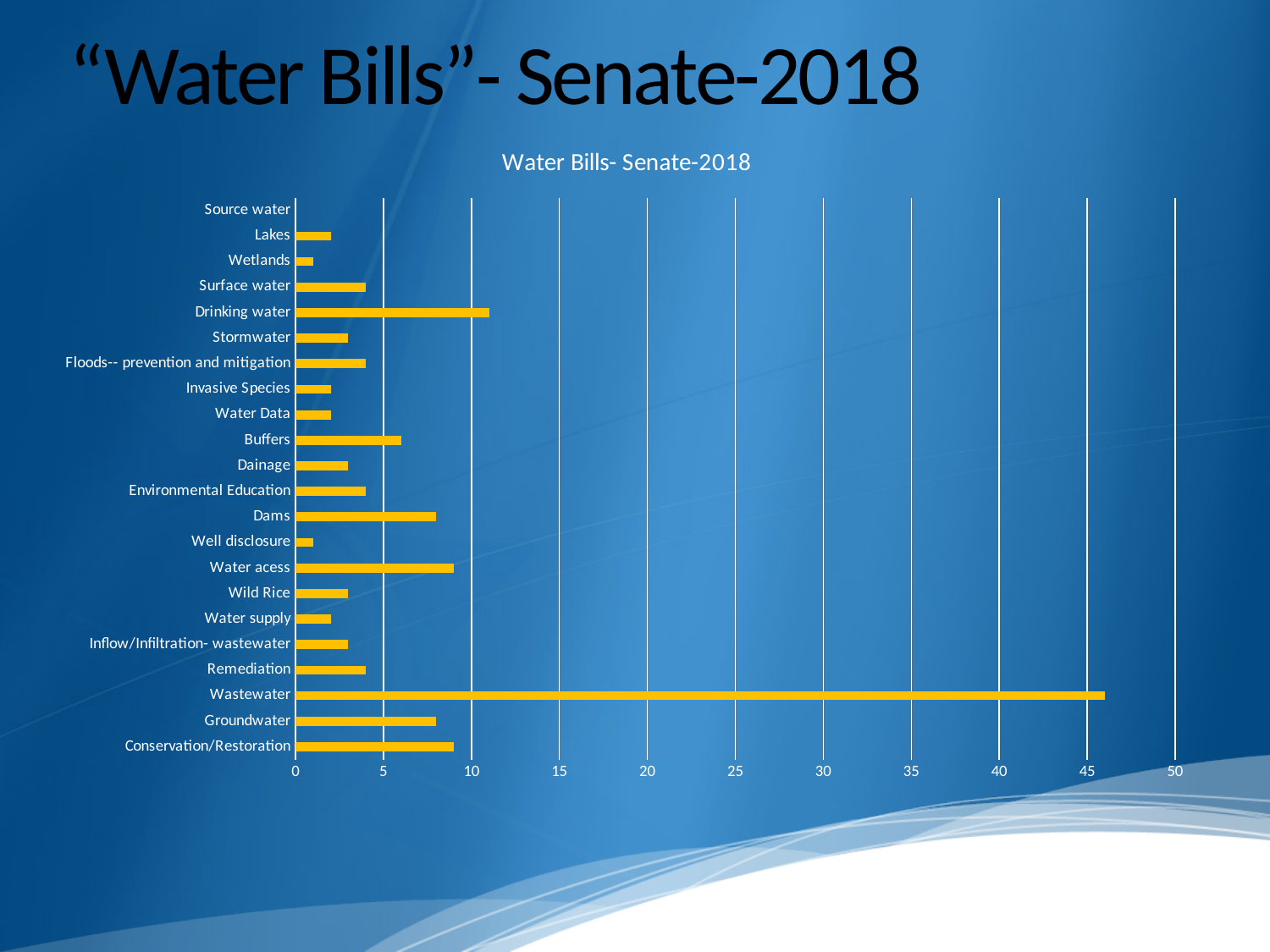
Which category has the lowest value? Source water Is the value for Drinking water greater or less than 10? greater Which is larger, the value for Buffers or the value for Well disclosure? Buffers Is the value for Dams greater or less than 10? less Is the value for Wastewater greater or less than 50? less What is the title of the chart? Water Bills- Senate-2018 How many categories are plotted on the chart? 22 Which category has the highest value? Wastewater Which is larger, the value for Drinking water or the value for Wetlands? Drinking water What kind of chart is shown on the slide? bar chart